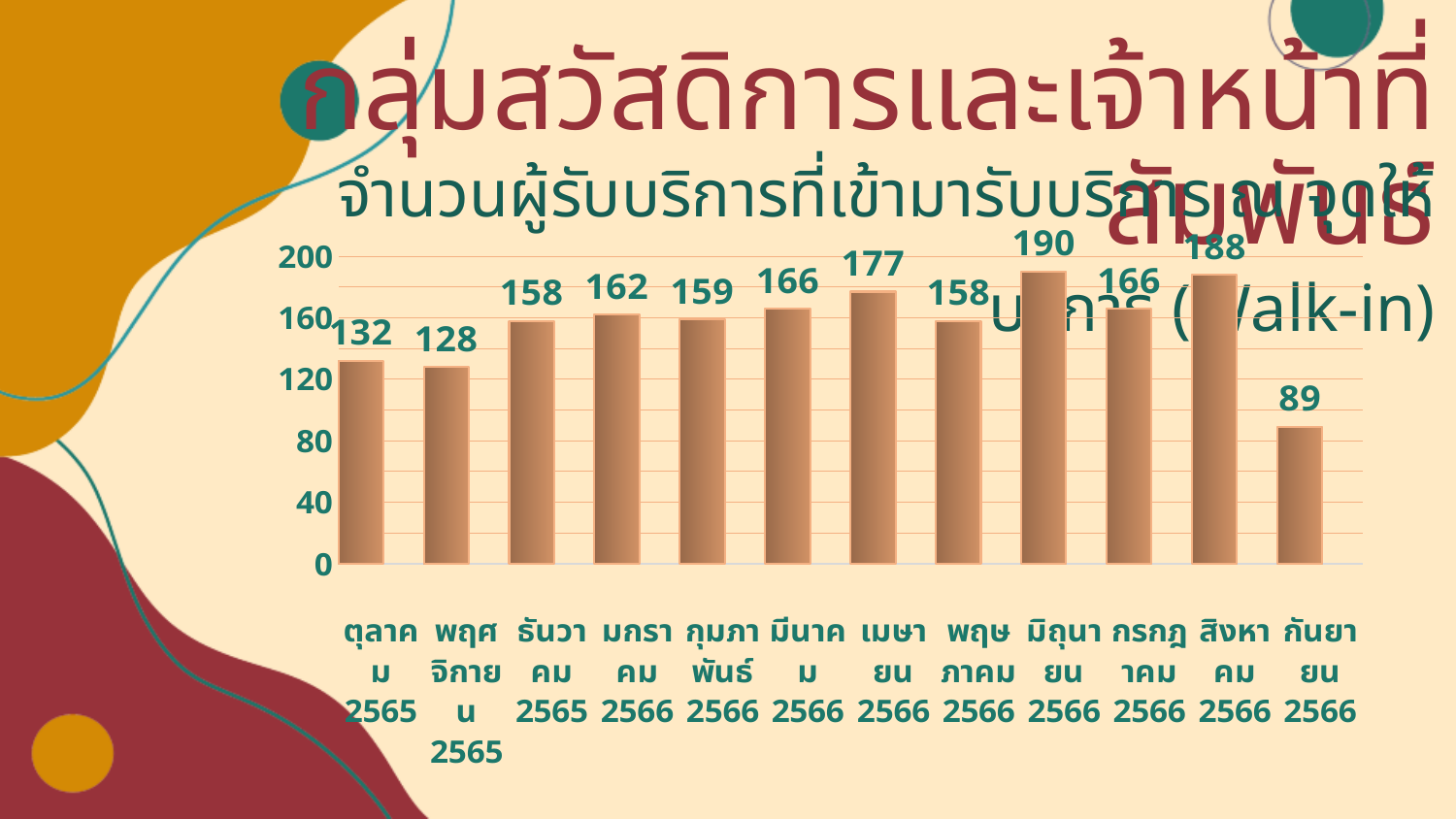
What kind of chart is shown on the slide? bar chart What is the value for เมษายน 2566? 177 How many months are shown on the x axis? 12 What is the value for มิถุนายน 2566? 190 What is the value for กันยายน 2566? 89 What is the difference between the values for มิถุนายน 2566 and กันยายน 2566? 101 Which is larger, the value for มกราคม 2566 or the value for กุมภาพันธ์ 2566? มกราคม 2566 Which month has the lowest value? กันยายน 2566 What is the difference between the values for สิงหาคม 2566 and กรกฎาคม 2566? 22 Which month has the highest value? มิถุนายน 2566 What is the value for ตุลาคม 2565? 132 Is the value for พฤศจิกายน 2565 greater or less than 160? less